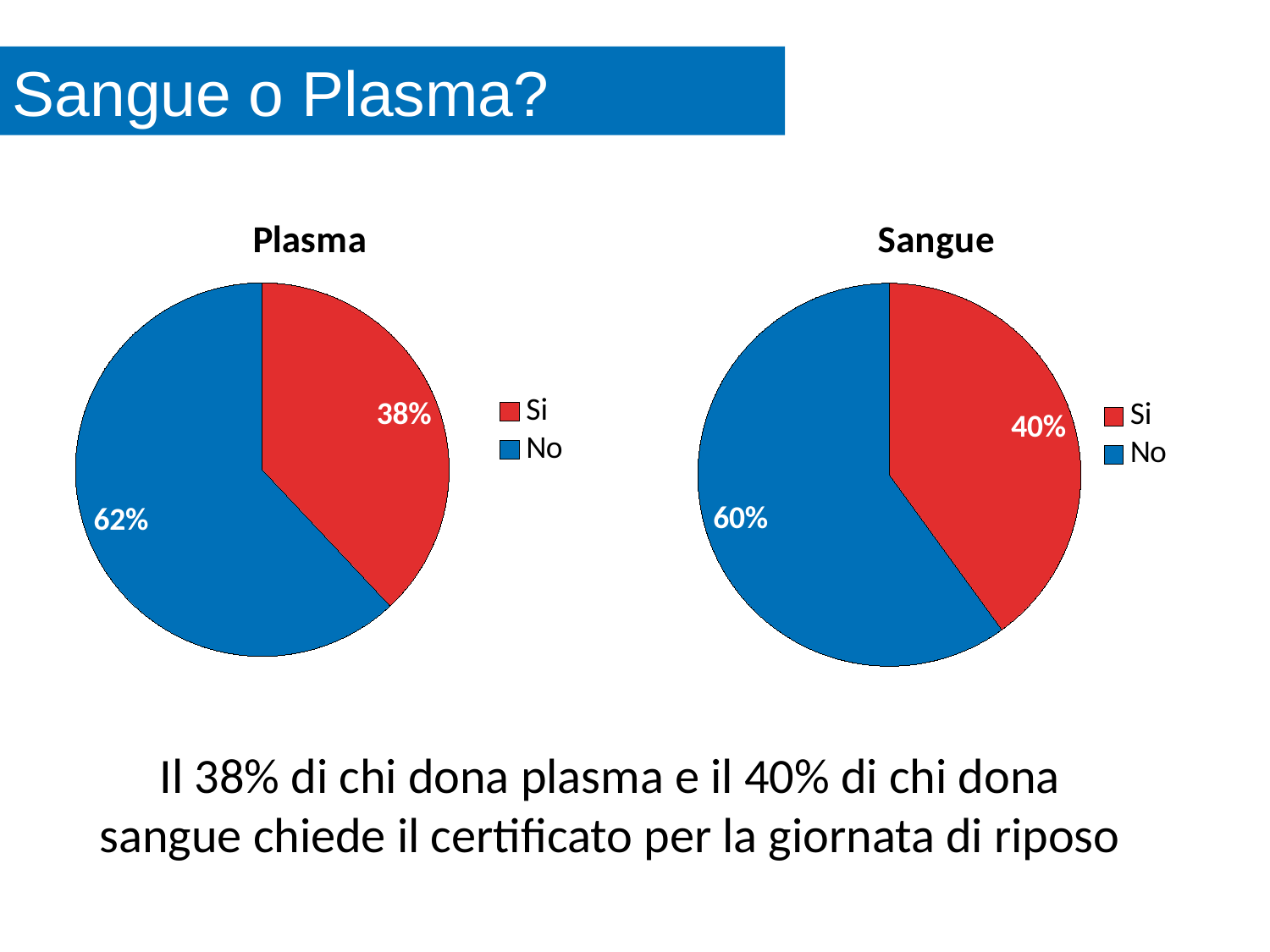
In the Sangue chart, what is the difference between the No and Si shares? 20% Which is larger: the Si share in the Plasma chart or the Si share in the Sangue chart? Sangue In the Sangue chart, what share of the pie is labelled Si? 40% In the Plasma chart, what is the difference between the No and Si shares? 24% In the Sangue chart, what share of the pie is labelled No? 60% What kind of chart is the Plasma chart? Pie chart In the Plasma chart, what share of the pie is labelled No? 62% How many slices does the Sangue chart have? 2 In the Plasma chart, which slice is the largest? No In the Sangue chart, which slice is the smallest? Si In the Plasma chart, what colour is the Si slice? Red